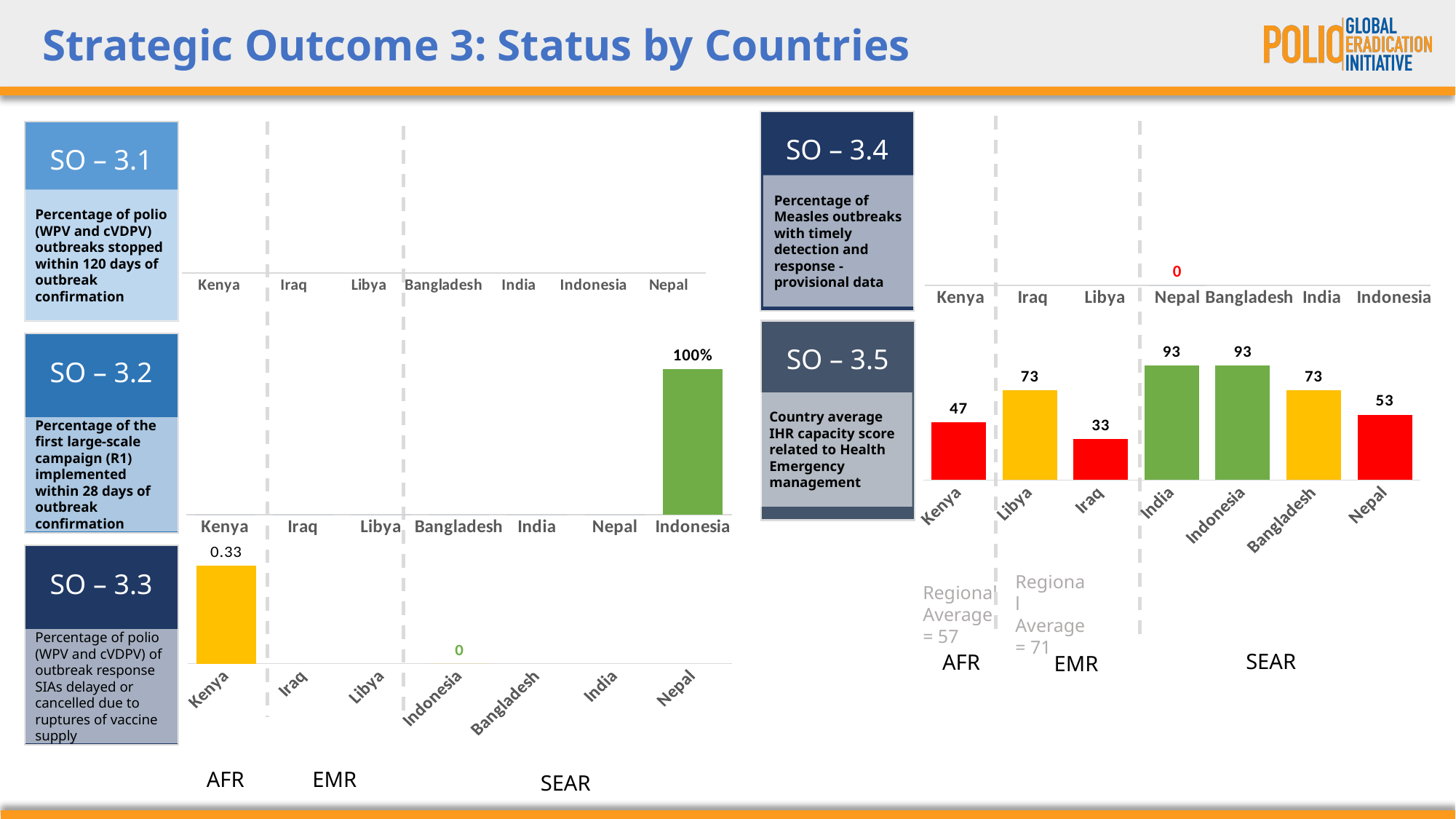
In the SO – 3.5 chart, what is the value for Nepal? 53 In the SO – 3.3 chart, what is the value for Kenya? 0.33 In the SO – 3.5 chart, what is the value for Iraq? 33 How many countries are shown on the x axis of the SO – 3.5 chart? 7 In the SO – 3.3 chart, what is the value for Indonesia? 0 In the SO – 3.4 chart, what is the value for Nepal? 0 In the SO – 3.5 chart, what is the value for Kenya? 47 In the SO – 3.5 chart, what is the difference between the values for India and Bangladesh? 20 In the SO – 3.2 chart, what is the value for Indonesia? 100% In the SO – 3.5 chart, which country has the lowest value? Iraq In the SO – 3.5 chart, which is larger, the value for Libya or the value for Kenya? Libya What kind of chart is the SO – 3.5 chart? Bar chart